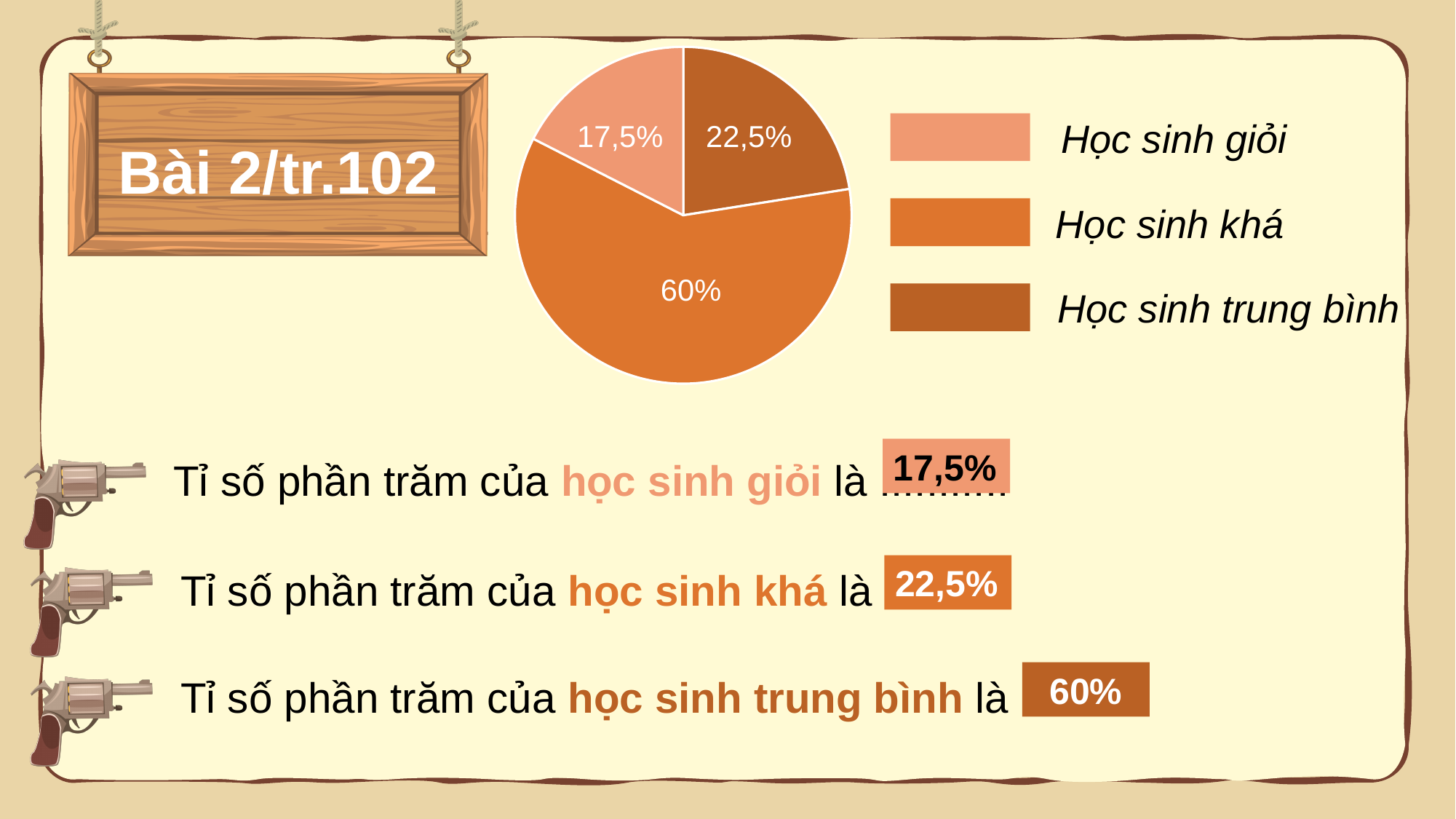
What value is printed on the smallest slice of the pie chart? 17,5% What value is printed on the largest slice of the pie chart? 60% Which is larger in the pie chart: the slice labelled 22,5% or the slice labelled 17,5%? 22,5% Which legend entry is shown with the lightest (salmon) colour in the pie chart? Học sinh giỏi What kind of chart is shown on the slide? pie chart What value is printed on the orange slice of the pie chart? 60% What is the difference between the 60% slice and the 22,5% slice in the pie chart? 37,5% What is the difference between the 22,5% slice and the 17,5% slice in the pie chart? 5% What value is printed on the dark brown slice of the pie chart? 22,5% What percentage is shown for Học sinh giỏi in the pie chart? 17,5% How many entries does the legend of the pie chart list? 3 How many slices does the pie chart have? 3